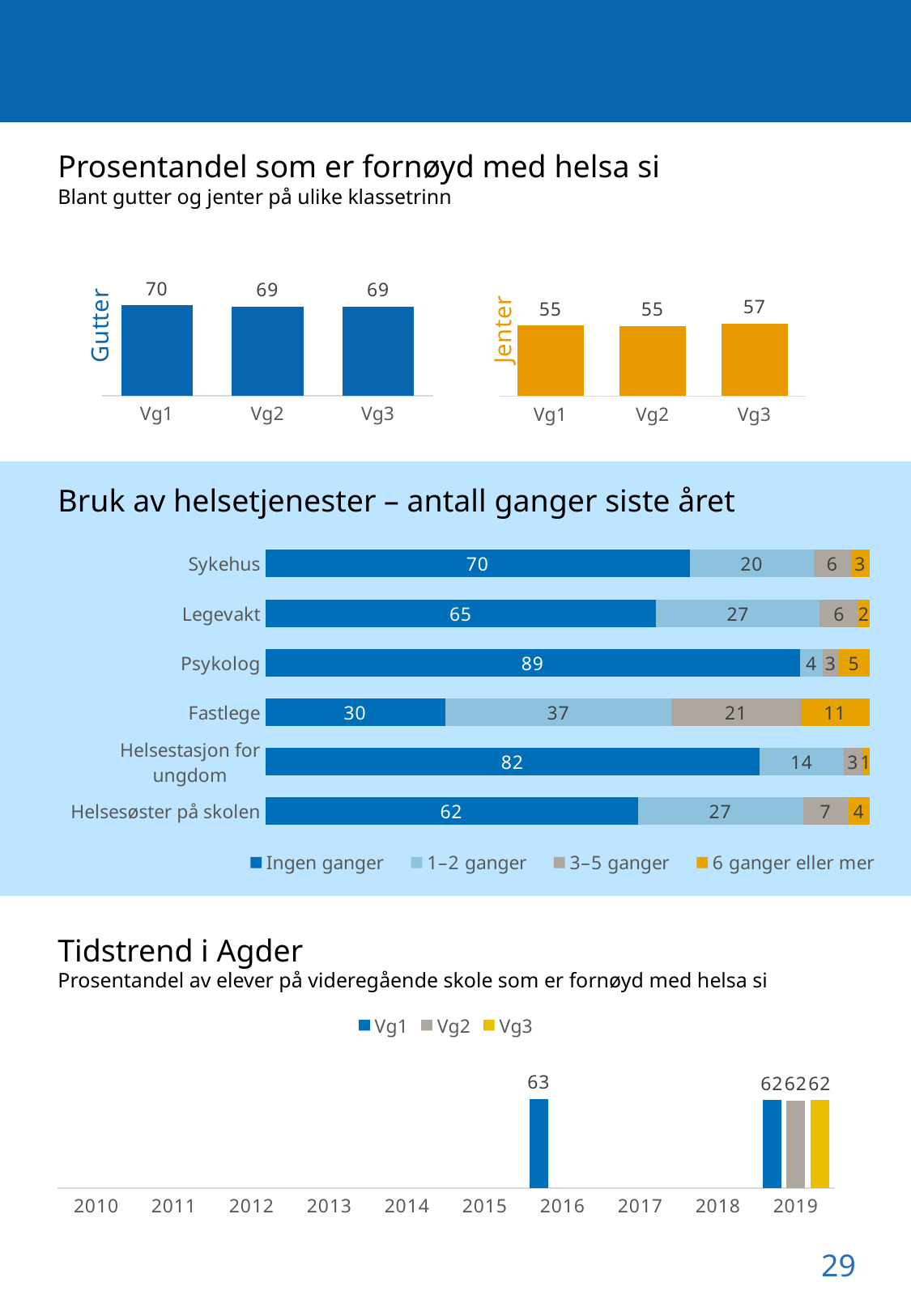
In the 'Tidstrend i Agder' chart, what is the Vg1 value for 2016? 63 What kind of chart is the 'Tidstrend i Agder' chart? bar chart In the 'Jenter' chart, what is the value for Vg2? 55 In the 'Bruk av helsetjenester' chart, what is the total of the Fastlege bar? 99 In the 'Bruk av helsetjenester' chart, how many categories are shown? 6 In the 'Bruk av helsetjenester' chart, how many series does the legend list? 4 In the 'Jenter' chart, which category has the highest value? Vg3 In the 'Bruk av helsetjenester' chart, which category has the lowest 'Ingen ganger' value? Fastlege In the 'Bruk av helsetjenester' chart, what is the '1–2 ganger' value for Fastlege? 37 In the 'Bruk av helsetjenester' chart, what is the 'Ingen ganger' value for Psykolog? 89 In the 'Gutter' chart, what is the value for Vg1? 70 What is the difference between the Vg1 value in the 'Gutter' chart and the Vg1 value in the 'Jenter' chart? 15